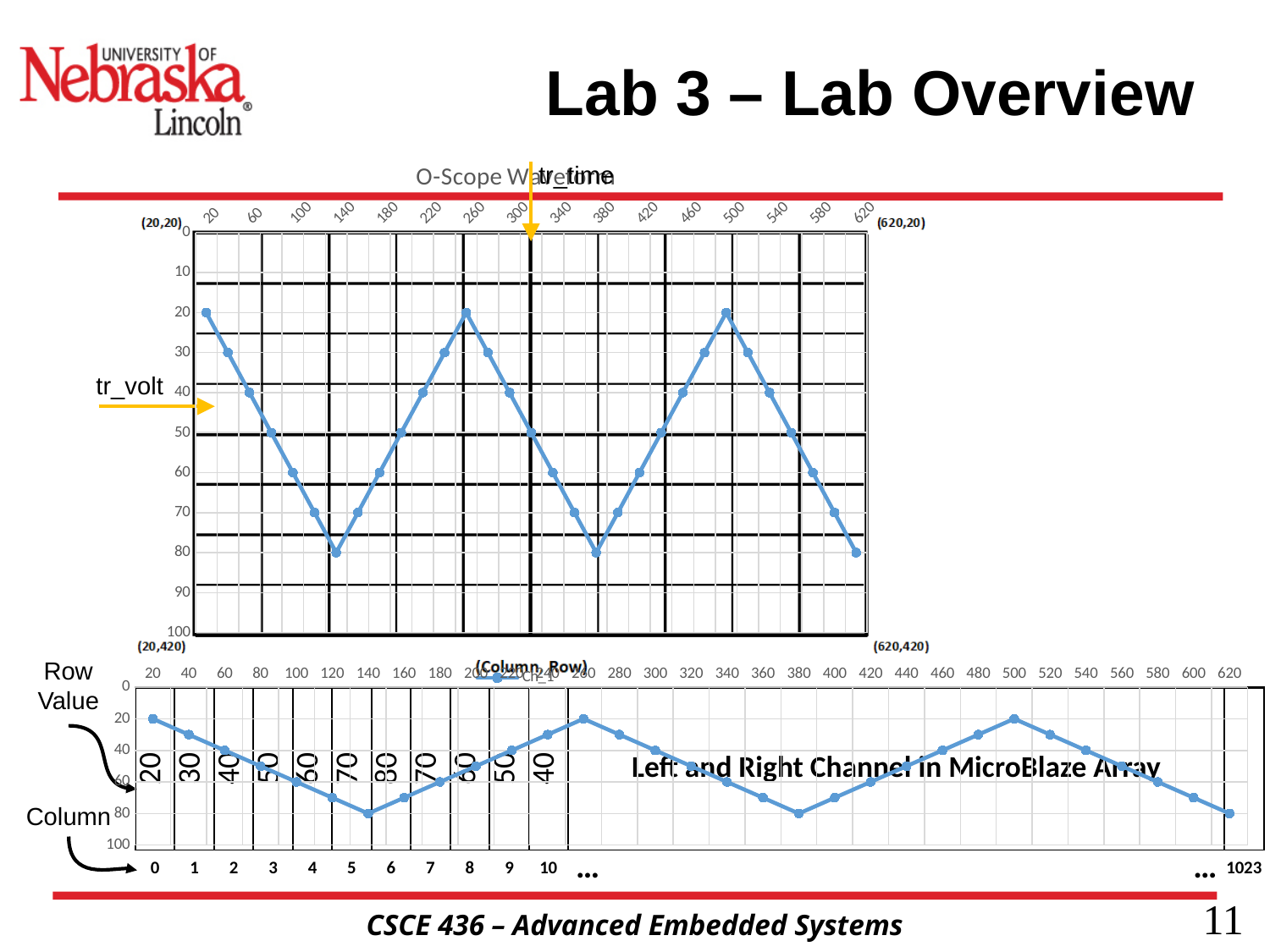
In the bottom chart, what is the row value printed for column 10? 40 In the bottom chart, what is the row value printed for column 6? 80 What kind of chart is the top chart titled "O-Scope Waveform"? line chart In the top "O-Scope Waveform" chart, what y-axis value does the point at x = 260 land on? 20 In the bottom chart, what is the difference between the row values for column 6 and column 0? 60 In the bottom chart, which has the larger row value, column 2 or column 8? column 8 In the top "O-Scope Waveform" chart, what is the last tick label on the x axis? 620 In the bottom chart, what is the row value printed for column 3? 50 In the top "O-Scope Waveform" chart, what y-axis value does the point at x = 140 land on? 80 In the bottom chart, what is the row value printed for column 0? 20 In the bottom chart, how many columns are labeled with printed row values (columns 0 through 10)? 11 In the bottom chart, do the printed row values rise or fall from column 0 to column 6? rise